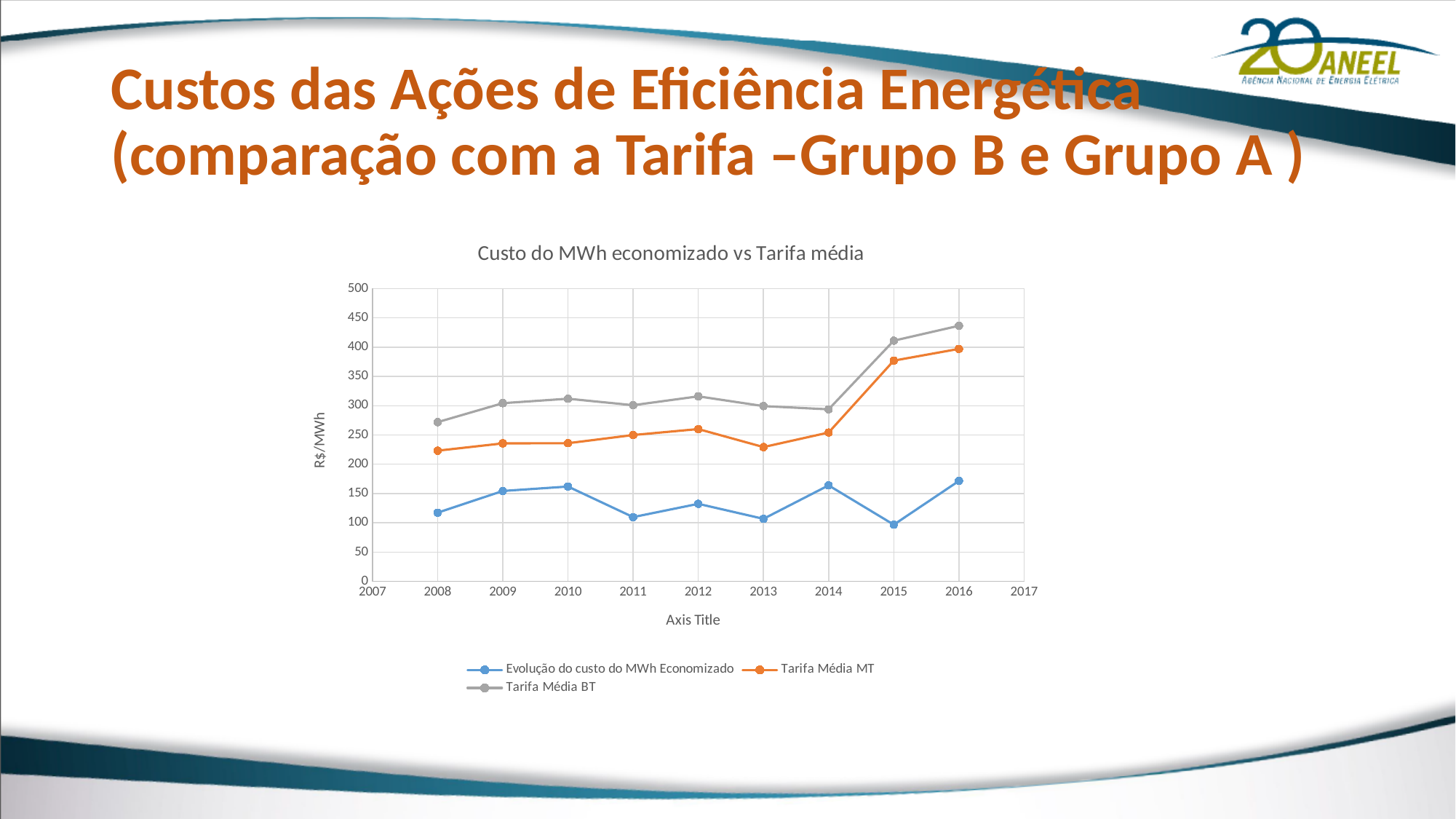
What kind of chart is shown on the slide? line chart Is the value for Tarifa Média BT in 2016 greater or less than 400? greater Is the value for Evolução do custo do MWh Economizado in 2015 greater or less than 150? less What is the title of the vertical axis? R$/MWh How many series does the legend list? 3 In which year is Tarifa Média BT at its highest? 2016 In 2012, which is higher: Tarifa Média MT or Evolução do custo do MWh Economizado? Tarifa Média MT In which year is Tarifa Média MT at its highest? 2016 How many years have plotted data points for each series? 9 Does Tarifa Média BT rise or fall from 2014 to 2016? rise Is the value for Tarifa Média MT in 2008 greater or less than 250? less